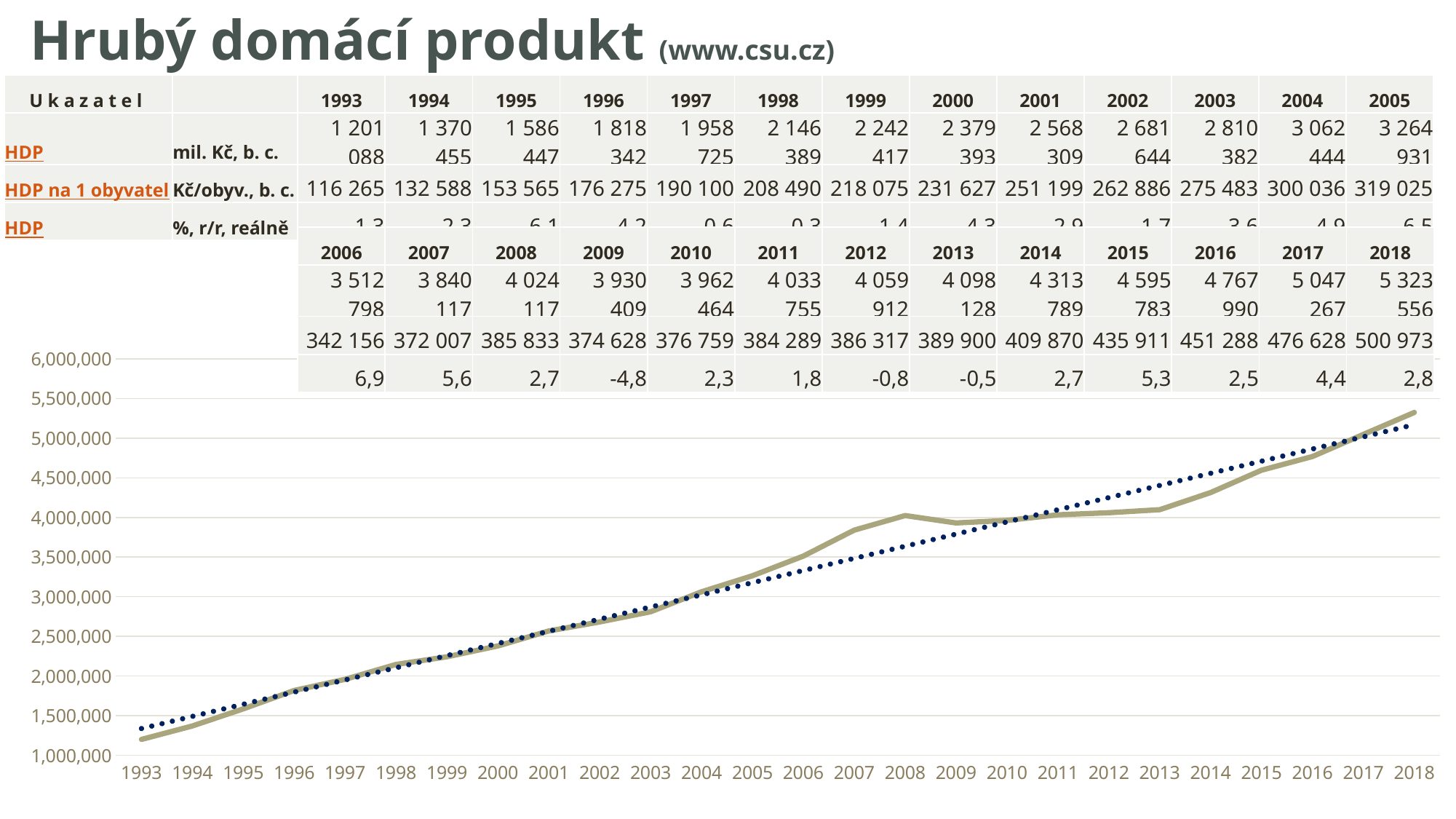
How many years are plotted along the x axis of the chart? 26 Is the plotted value for 2000 greater or less than 2,500,000? less According to the table, what is the HDP in mil. Kč for 2018? 5 323 556 Which year has the larger plotted value, 2008 or 2009? 2008 Which year has the lowest plotted value on the chart? 1993 Is the plotted value for 2005 greater or less than 3,000,000? greater Do the plotted GDP values generally rise or fall from 1993 to 2018? rise What kind of chart is shown on the slide? line chart Which year has the highest plotted value on the chart? 2018 What is the highest tick value shown on the chart's vertical axis? 6,000,000 Is the plotted value for 1993 greater or less than 1,500,000? less